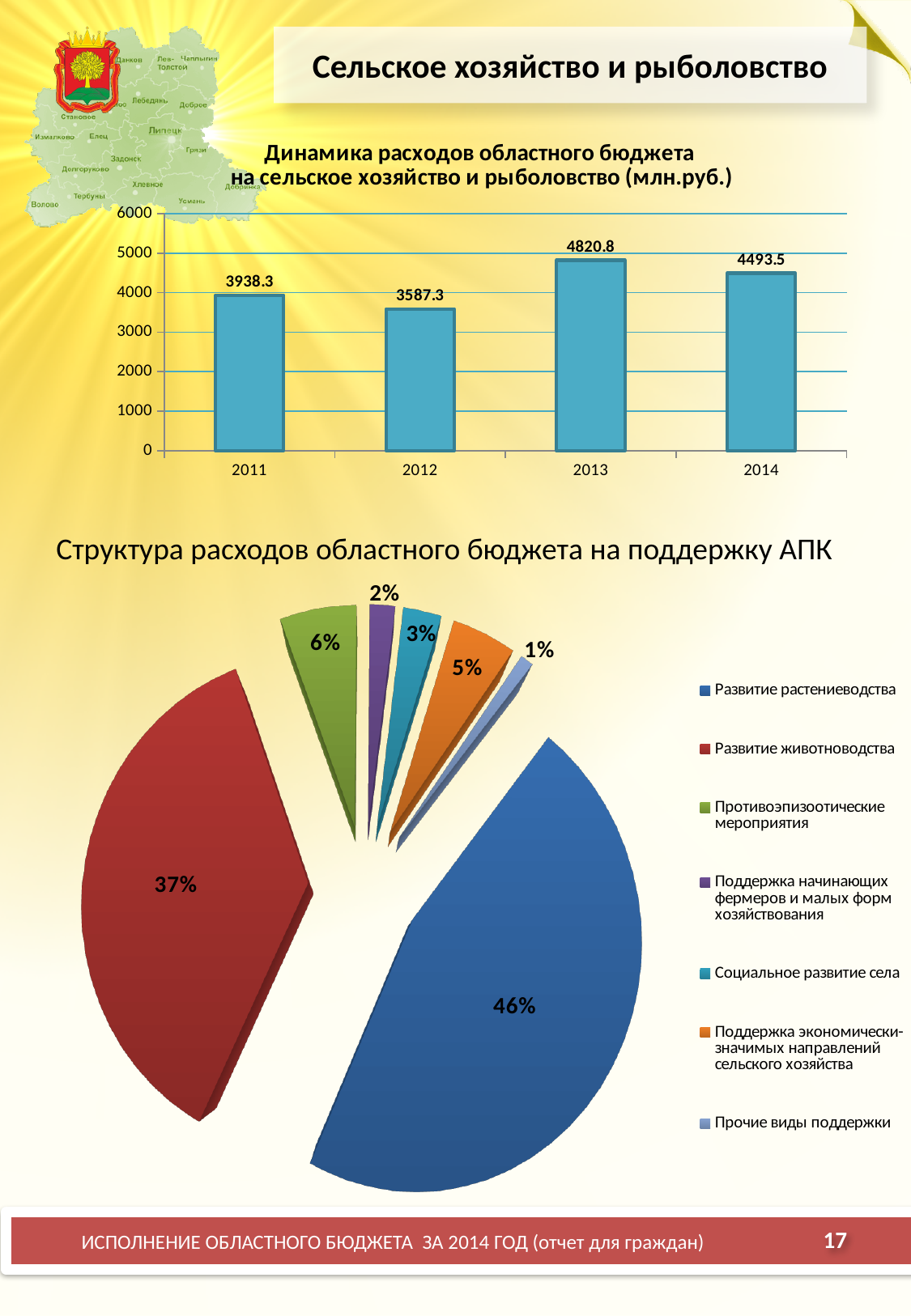
How many years are shown in the top bar chart? 4 In the bottom pie chart, which category has the smallest share? Прочие виды поддержки What type of chart is the top chart on the slide? bar chart In the top bar chart, which year has the highest expenditure? 2013 In the top bar chart, what was the regional budget expenditure on agriculture and fishing in 2013? 4820.8 In the top bar chart, which year has the lowest expenditure? 2012 In the top bar chart, what is the value for 2012? 3587.3 In the top bar chart, is the value for 2011 greater or less than 4000? less In the bottom pie chart, what share does Противоэпизоотические мероприятия have? 6% How many categories does the legend of the bottom pie chart list? 7 In the bottom pie chart, what share does Развитие растениеводства have? 46% In the top bar chart, what is the difference between the 2013 and 2014 values? 327.3